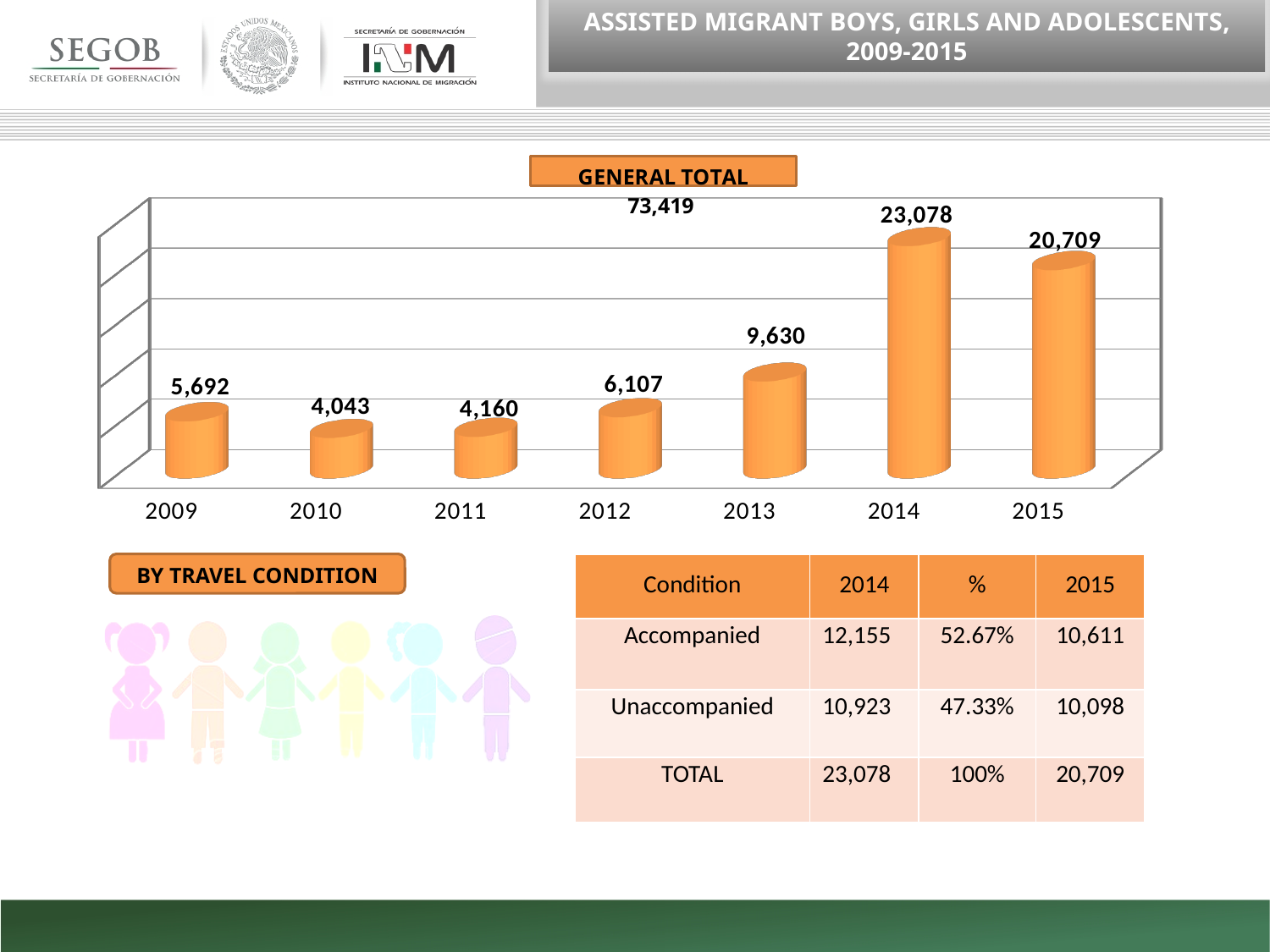
Which year has the highest value in the chart? 2014 How many years are plotted in the chart? 7 What is the difference between the values for 2014 and 2015? 2,369 What is the value for 2013 in the chart? 9,630 Which is larger, the value for 2011 or the value for 2010? 2011 Which year has the lowest value in the chart? 2010 What is the value for 2009 in the chart? 5,692 What type of chart is shown on the slide? bar chart Do the values rise or fall from 2011 to 2014? rise What is the difference between the values for 2013 and 2012? 3,523 What is the title shown above the chart? GENERAL TOTAL What is the value for 2014 in the chart? 23,078